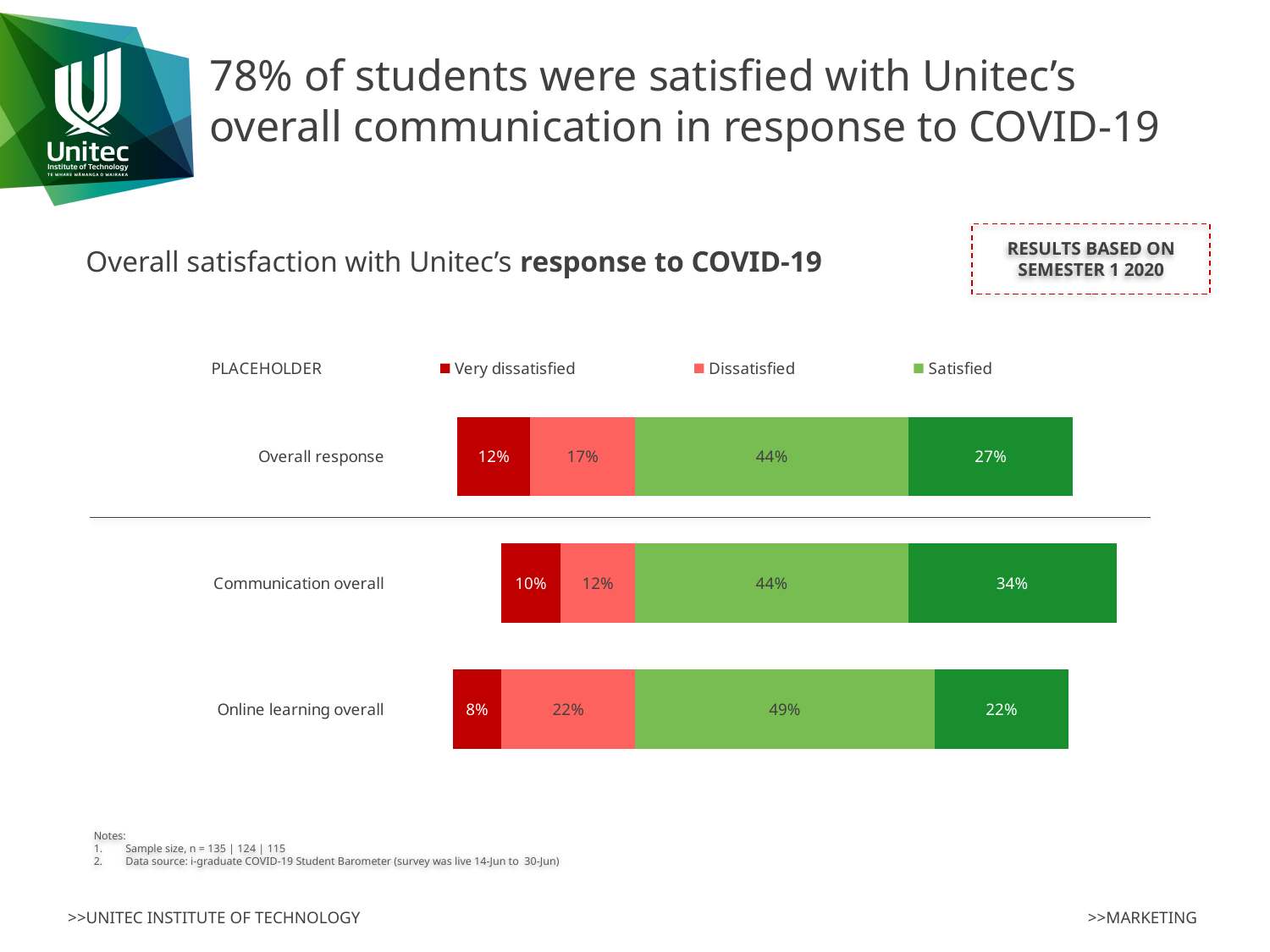
Which category has the lowest Very dissatisfied percentage? Online learning overall What percentage of students were very dissatisfied with the Overall response? 12% What is the Dissatisfied value for Online learning overall? 22% Which category has the highest Dissatisfied percentage? Online learning overall Which has a larger Satisfied value, Online learning overall or Overall response? Online learning overall How many categories are shown in the chart? 3 What is the Satisfied value for Communication overall? 44% How many percentage points higher is the Dissatisfied value for Online learning overall than for Communication overall? 10 percentage points Which category has the highest Very dissatisfied percentage? Overall response What is the Satisfied value for Online learning overall? 49% What type of chart is shown on the slide? Stacked bar chart What is the title of the chart? Overall satisfaction with Unitec's response to COVID-19